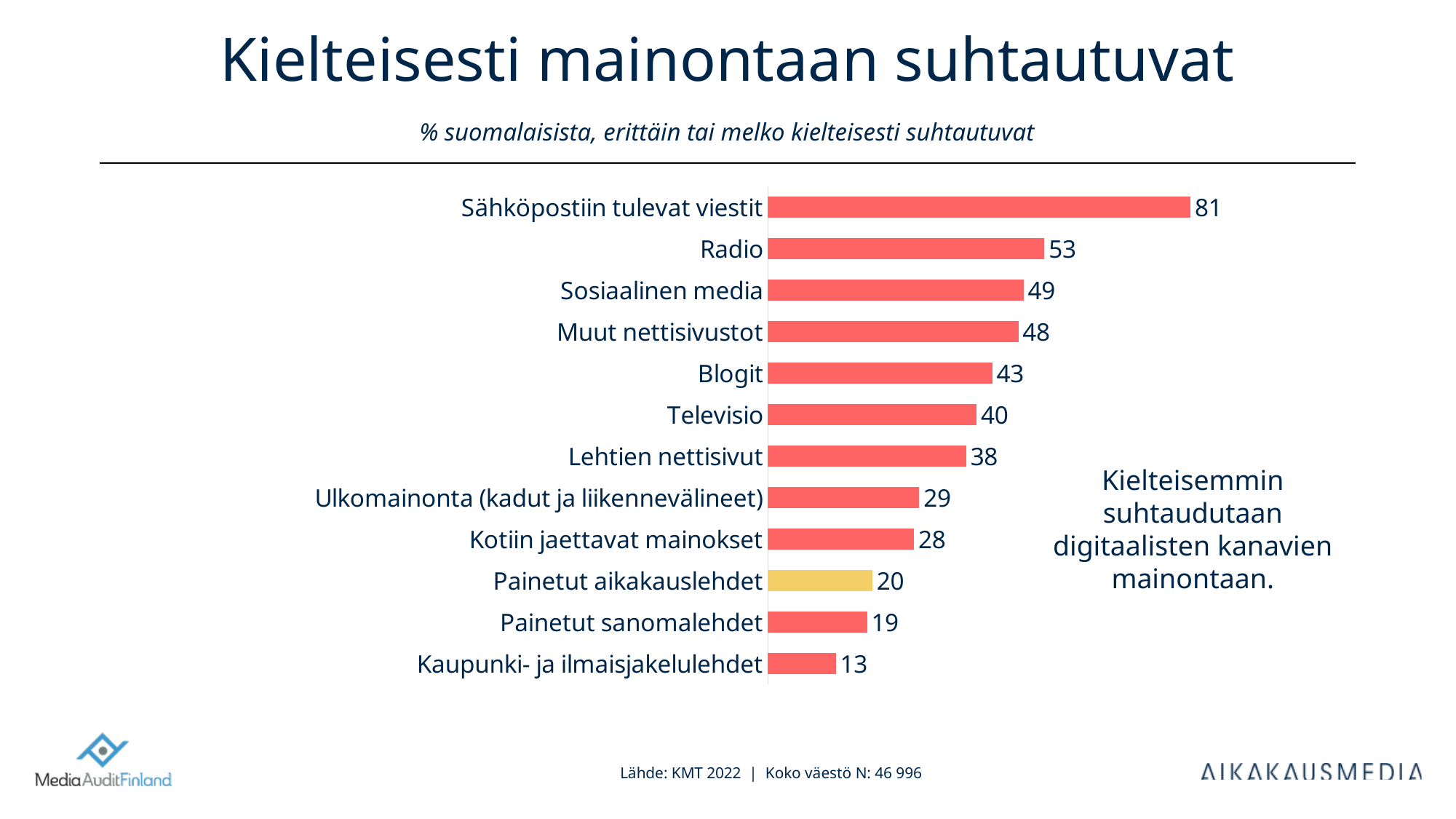
How many categories are shown in the chart? 12 What kind of chart is shown on the slide? Bar chart Which category has the highest value? Sähköpostiin tulevat viestit What is the title of the chart on the slide? Kielteisesti mainontaan suhtautuvat What is the value for Painetut aikakauslehdet? 20 What is the difference between the values for Radio and Painetut sanomalehdet? 34 Which is larger, the value for Blogit or the value for Lehtien nettisivut? Blogit Which category has the lowest value? Kaupunki- ja ilmaisjakelulehdet Which bar is coloured differently (yellow) from the others? Painetut aikakauslehdet What is the value for Televisio? 40 What is the value for Sähköpostiin tulevat viestit? 81 What is the difference between the values for Sosiaalinen media and Muut nettisivustot? 1